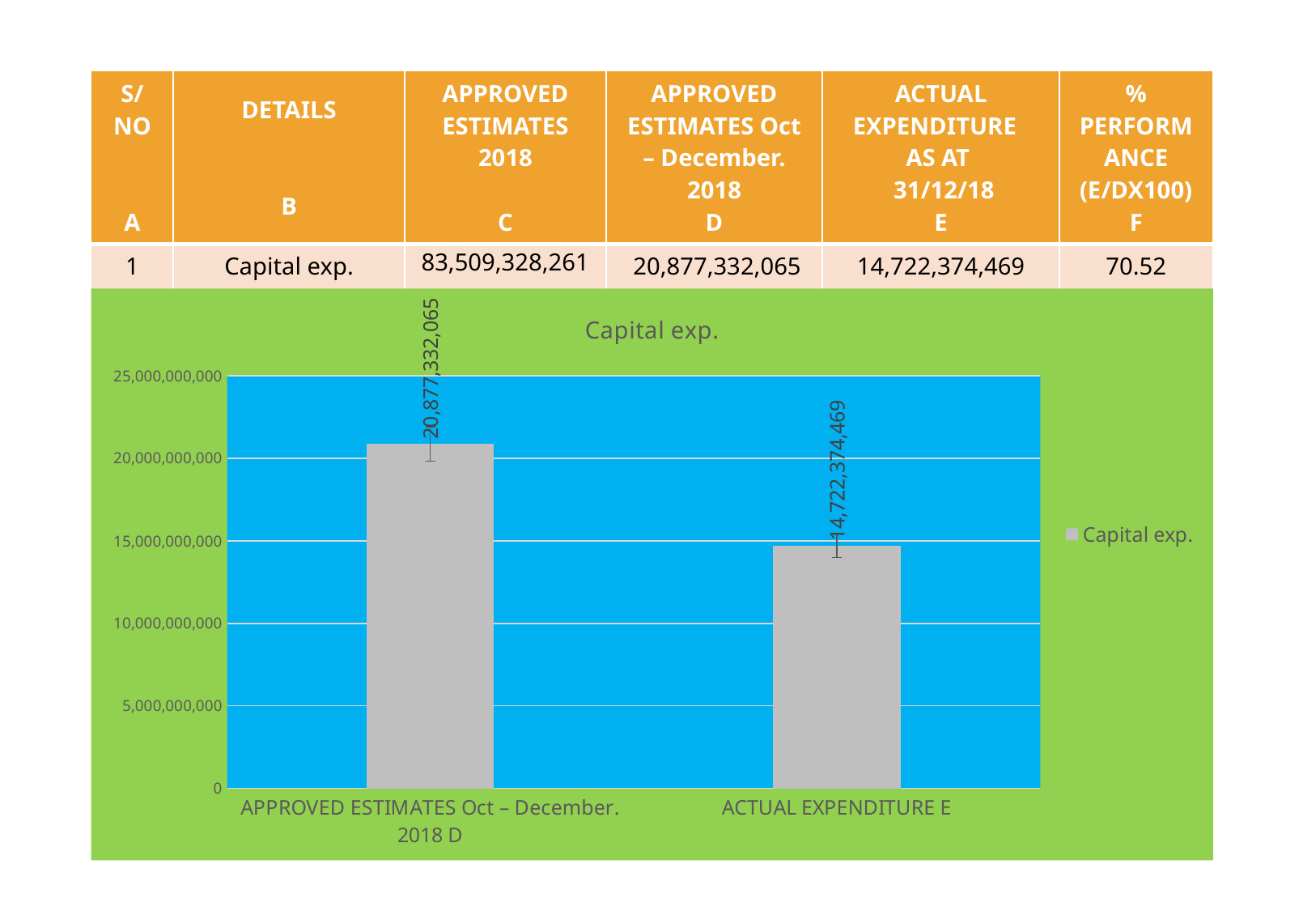
What is the value of the APPROVED ESTIMATES Oct – December. 2018 D bar? 20,877,332,065 Which is larger, the APPROVED ESTIMATES Oct – December. 2018 D bar or the ACTUAL EXPENDITURE E bar? APPROVED ESTIMATES Oct – December. 2018 D What is the value of the ACTUAL EXPENDITURE E bar? 14,722,374,469 What kind of chart is shown on the slide? Bar chart Is the value for APPROVED ESTIMATES Oct – December. 2018 D greater or less than 20,000,000,000? greater Which category has the lowest bar? ACTUAL EXPENDITURE E Is the value for ACTUAL EXPENDITURE E greater or less than 15,000,000,000? less Which category has the highest bar? APPROVED ESTIMATES Oct – December. 2018 D What is the title of the chart? Capital exp. What is the difference between the APPROVED ESTIMATES Oct – December. 2018 D bar and the ACTUAL EXPENDITURE E bar? 6,154,957,596 How many series does the legend list? 1 How many bars are plotted in the chart? 2